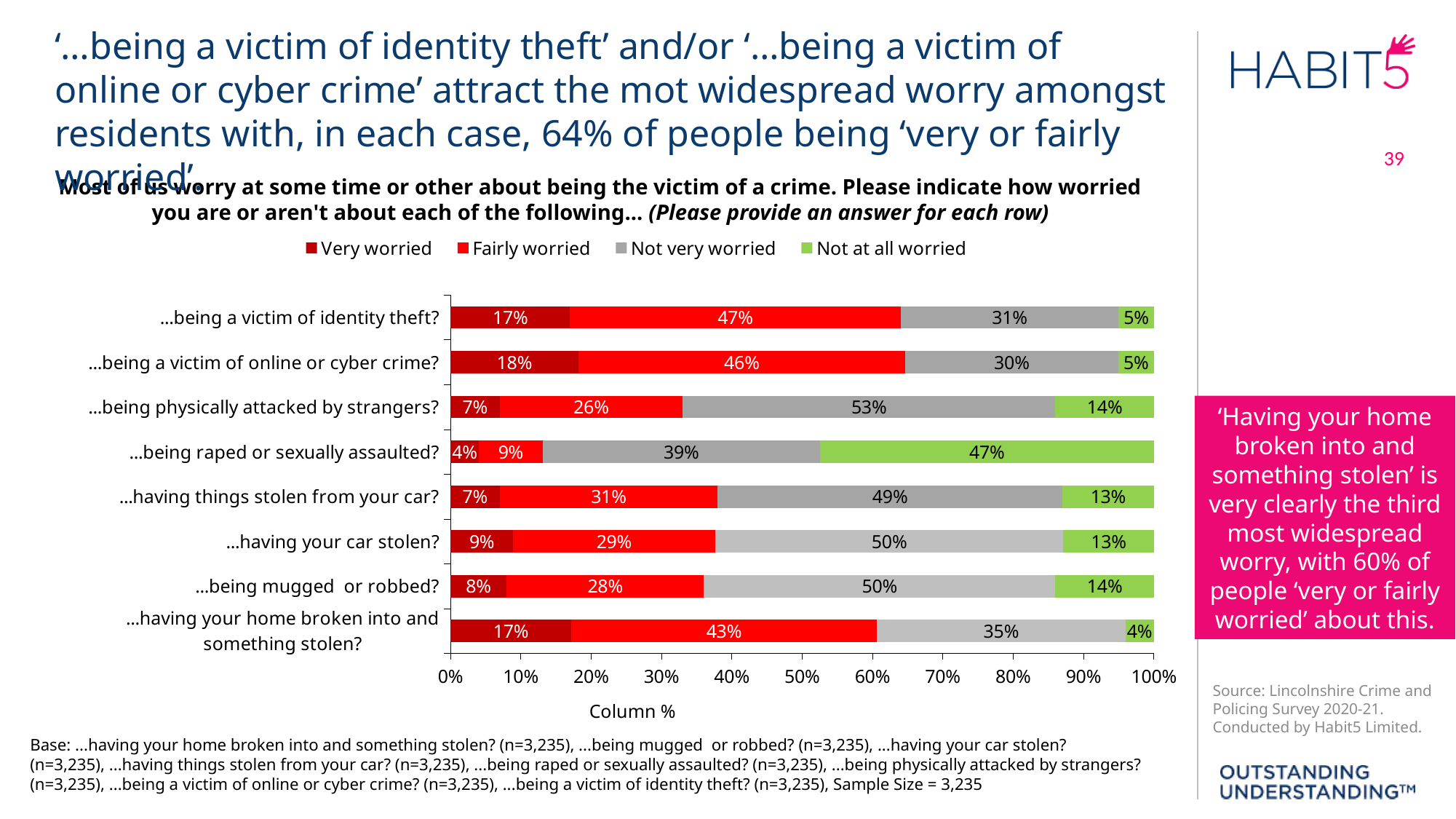
Which has a larger 'Fairly worried' percentage: having things stolen from your car or having your car stolen? ...having things stolen from your car? What percentage of respondents are 'Not at all worried' about being raped or sexually assaulted? 47% What type of chart is shown on the slide? Stacked bar chart What is the difference in percentage points between the 'Not very worried' value for being physically attacked by strangers and for being a victim of identity theft? 22 percentage points How many series does the legend list? 4 Which category has the highest 'Not very worried' percentage? ...being physically attacked by strangers? Which category has the highest 'Very worried' percentage? ...being a victim of online or cyber crime? What percentage of respondents are 'Not very worried' about having their car stolen? 50% How many crime categories are shown in the chart? 8 What percentage of respondents are 'Fairly worried' about being a victim of identity theft? 47% Which category has the lowest 'Very worried' percentage? ...being raped or sexually assaulted? What is the combined 'Very worried' and 'Fairly worried' percentage for having your home broken into and something stolen? 60%